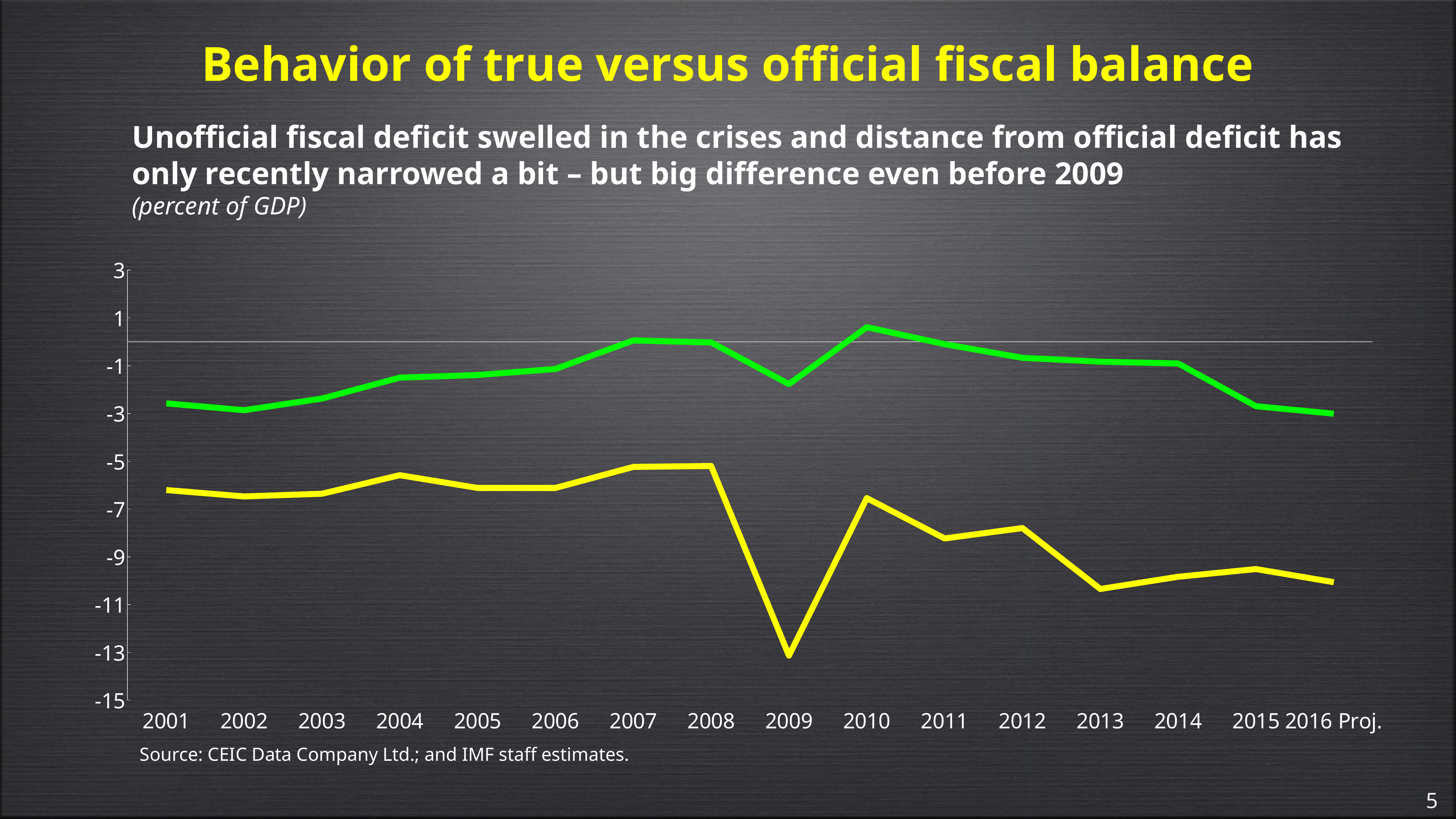
Is the value of the yellow line in 2001 greater or less than -5? less What is the title of the chart on the slide? Behavior of true versus official fiscal balance How many years are shown along the x axis of the chart? 16 What kind of chart is shown on the slide? line chart Is the value of the yellow line in 2009 greater or less than -11? less Is the value of the yellow line in 2013 greater or less than -9? less In which year does the yellow line reach its lowest value? 2009 Does the green line rise or fall between 2014 and 2016 Proj.? fall Which line is higher in 2009, the green line or the yellow line? the green line In which year does the green line reach its highest value? 2010 Does the yellow line rise or fall between 2008 and 2009? fall